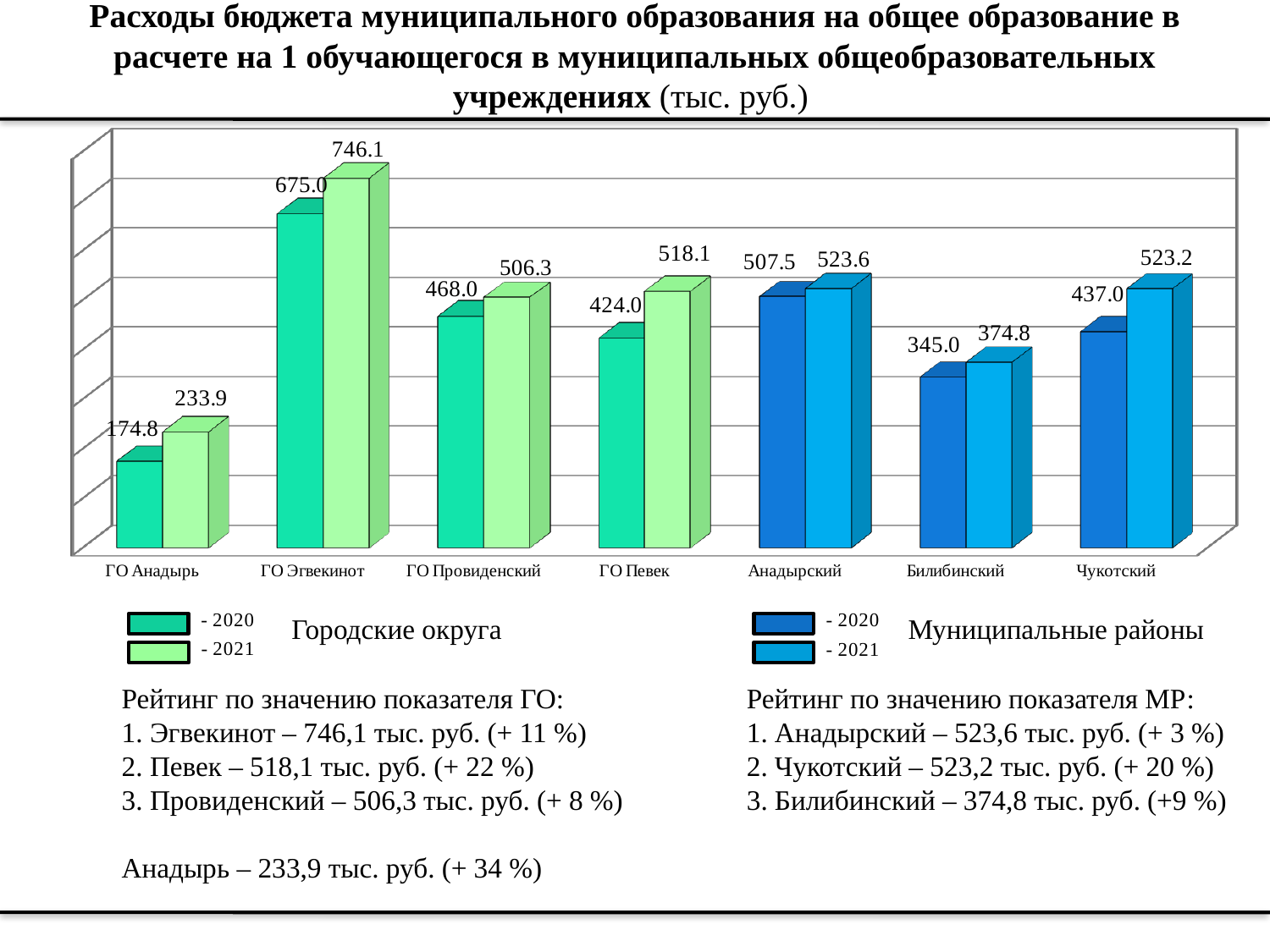
Which category has the lowest 2020 value? ГО Анадырь Which two years does the legend list? 2020 and 2021 What is the 2020 value for Билибинский? 345.0 What is the difference between the 2021 and 2020 values for ГО Певек? 94.1 Which category has the highest 2021 value? ГО Эгвекинот What is the difference between the 2021 and 2020 values for ГО Эгвекинот? 71.1 What is the 2021 value for ГО Эгвекинот? 746.1 What is the 2020 value for Чукотский? 437.0 What is the 2021 value for ГО Певек? 518.1 What kind of chart is shown on the slide? bar chart Which is larger: the 2021 value for Билибинский or the 2021 value for Чукотский? Чукотский How many categories are shown on the x axis? 7